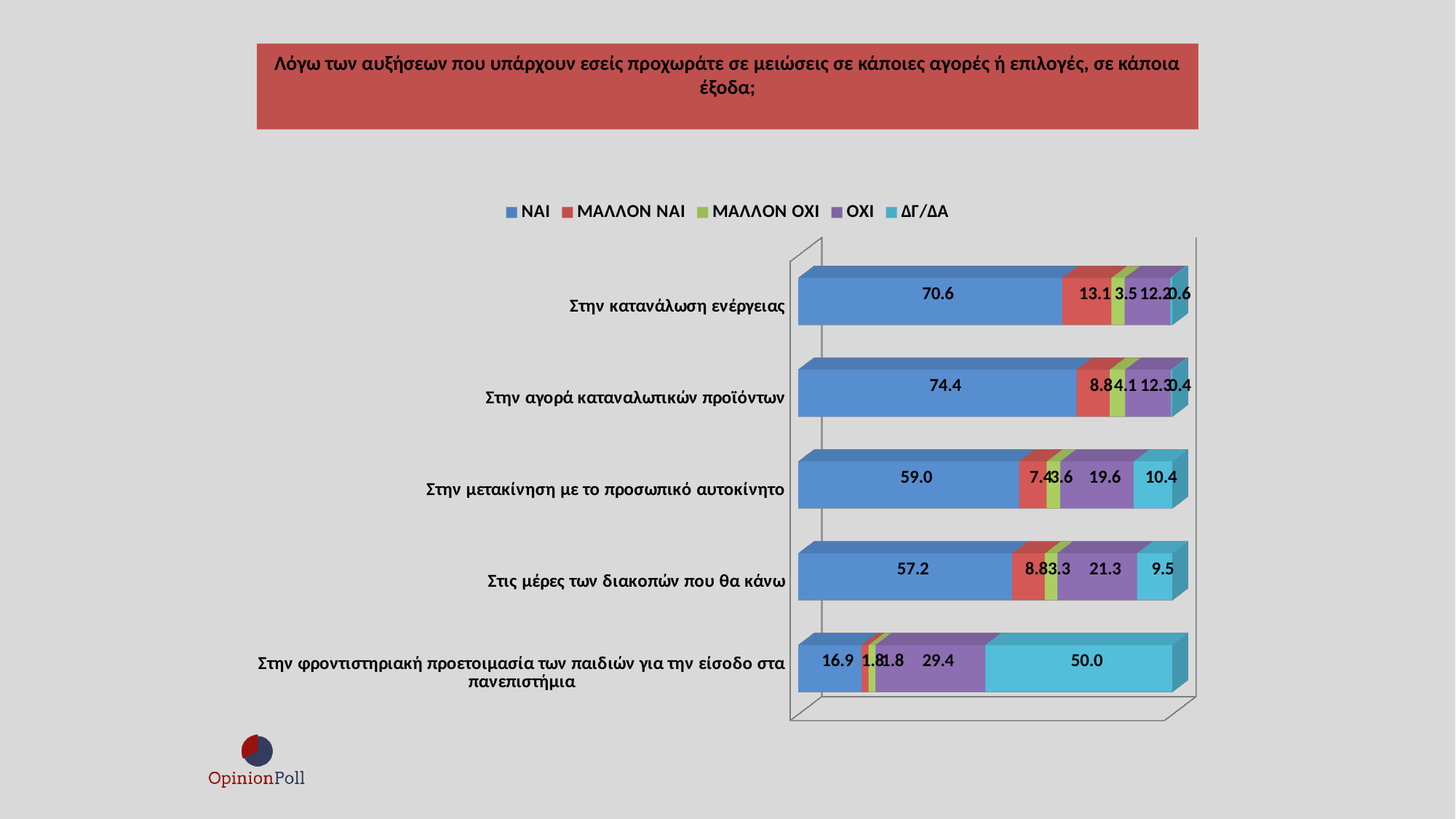
What is the ΝΑΙ value for 'Στην αγορά καταναλωτικών προϊόντων'? 74.4 How many series does the legend list? 5 What kind of chart is shown on the slide? stacked bar chart What is the ΝΑΙ value for 'Στην κατανάλωση ενέργειας'? 70.6 How many categories are plotted on the chart? 5 What is the ΔΓ/ΔΑ value for 'Στην φροντιστηριακή προετοιμασία των παιδιών για την είσοδο στα πανεπιστήμια'? 50.0 What is the ΟΧΙ value for 'Στις μέρες των διακοπών που θα κάνω'? 21.3 Which category has the lowest ΝΑΙ value? Στην φροντιστηριακή προετοιμασία των παιδιών για την είσοδο στα πανεπιστήμια Which category has the highest ΝΑΙ value? Στην αγορά καταναλωτικών προϊόντων What colour represents the ΔΓ/ΔΑ series in the legend? light blue Which is larger: the ΟΧΙ value for 'Στην μετακίνηση με το προσωπικό αυτοκίνητο' or the ΟΧΙ value for 'Στις μέρες των διακοπών που θα κάνω'? Στις μέρες των διακοπών που θα κάνω What is the difference between the ΝΑΙ values for 'Στην αγορά καταναλωτικών προϊόντων' and 'Στην κατανάλωση ενέργειας'? 3.8